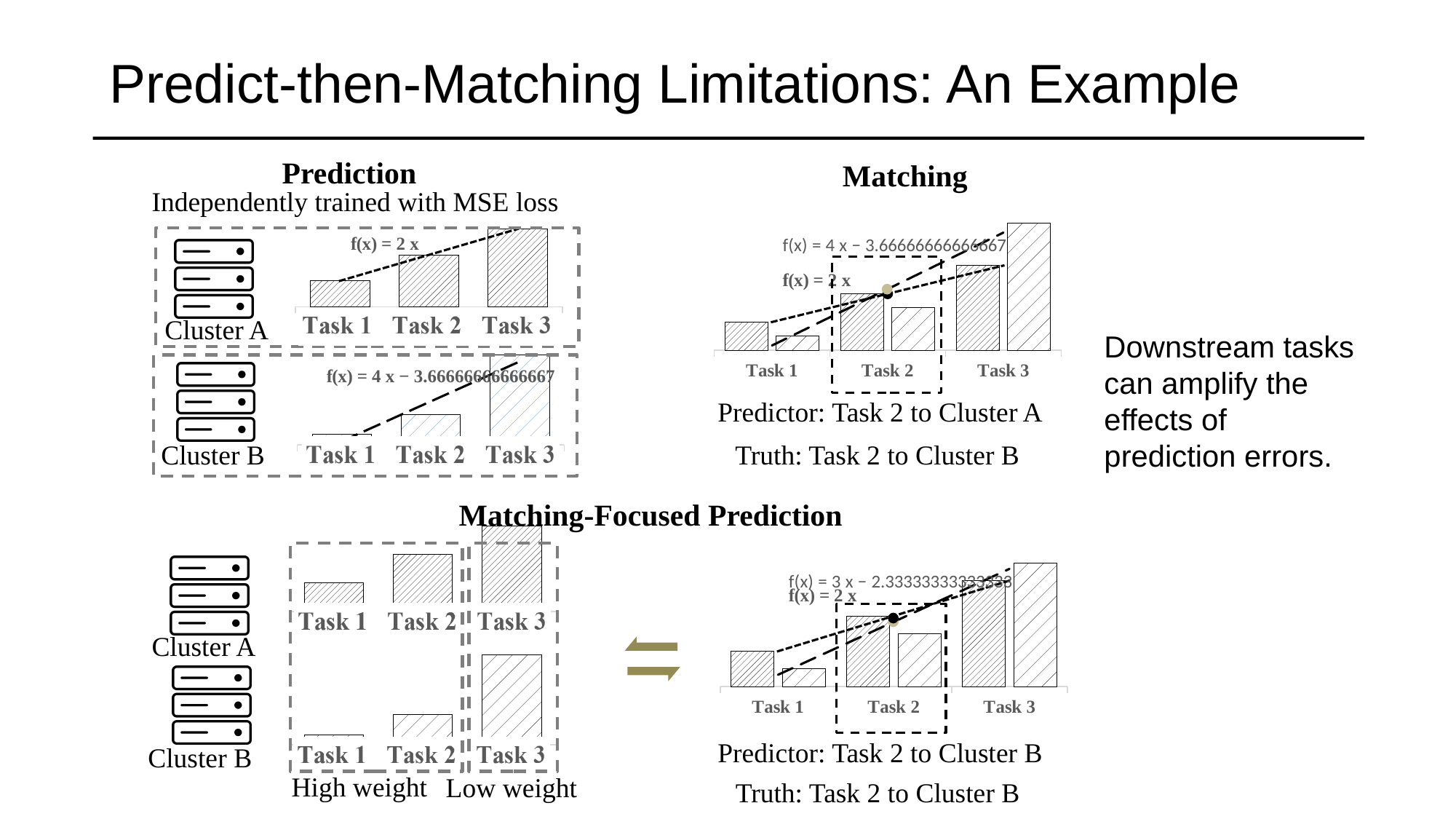
In the Prediction chart for Cluster B (left, second row), which task has the tallest bar? Task 3 In the Prediction chart for Cluster B (left, second row), what is the trendline equation shown? f(x) = 4 x − 3.66666666666667 In the Prediction chart for Cluster A (top left), do the bars rise or fall from Task 1 to Task 3? Rise In the Prediction chart for Cluster A (top left), which task has the tallest bar? Task 3 In the Prediction chart for Cluster A (top left), how many tasks are shown on the x axis? 3 In the Prediction chart for Cluster A (top left), what is the trendline equation shown? f(x) = 2 x In the Prediction chart for Cluster A (top left), which task has the shortest bar? Task 1 In the Matching-Focused Prediction chart for Cluster A (bottom left), do the bars rise or fall from Task 1 to Task 3? Rise In the Prediction chart for Cluster A (top left), what kind of chart is used? Bar chart In the Matching-Focused Prediction chart for Cluster B (bottom left), which task has the shortest bar? Task 1 In the bottom-right matching chart, which task has the tallest bar? Task 3 In the Matching chart (top right), how many task categories are shown on the x axis? 3